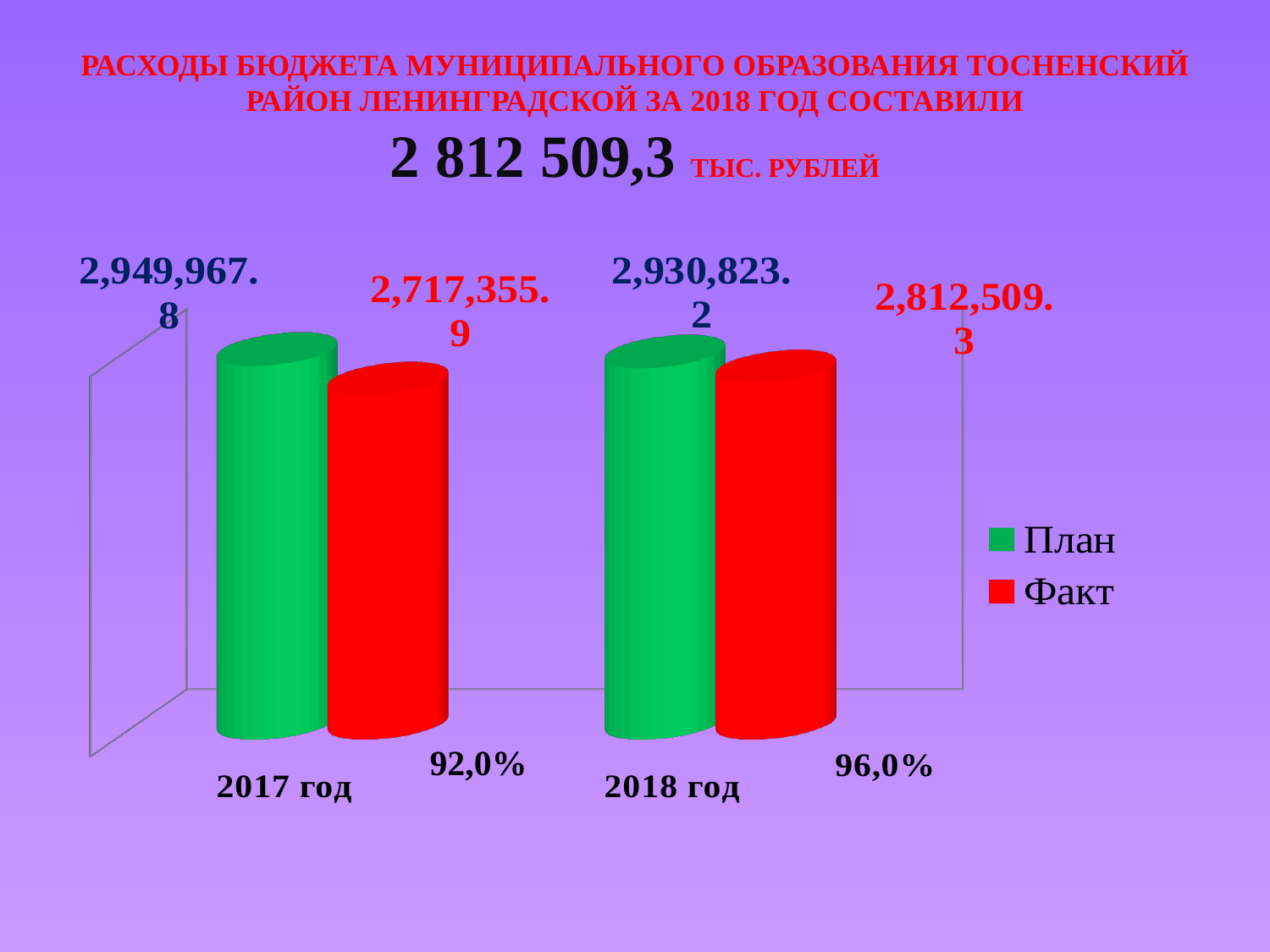
Which year has the higher Факт value? 2018 год How many categories (years) are shown on the chart? 2 Is the Факт value for 2018 год larger or smaller than the Факт value for 2017 год? larger What is the План value for 2017 год? 2,949,967.8 What is the Факт value for 2017 год? 2,717,355.9 What is the difference between План and Факт for 2018 год? 118,313.9 How many series does the legend list? 2 What is the difference between План and Факт for 2017 год? 232,611.9 Which bar has the lowest value on the chart? Факт, 2017 год What is the План value for 2018 год? 2,930,823.2 What kind of chart is shown on the slide? bar chart What is the Факт value for 2018 год? 2,812,509.3